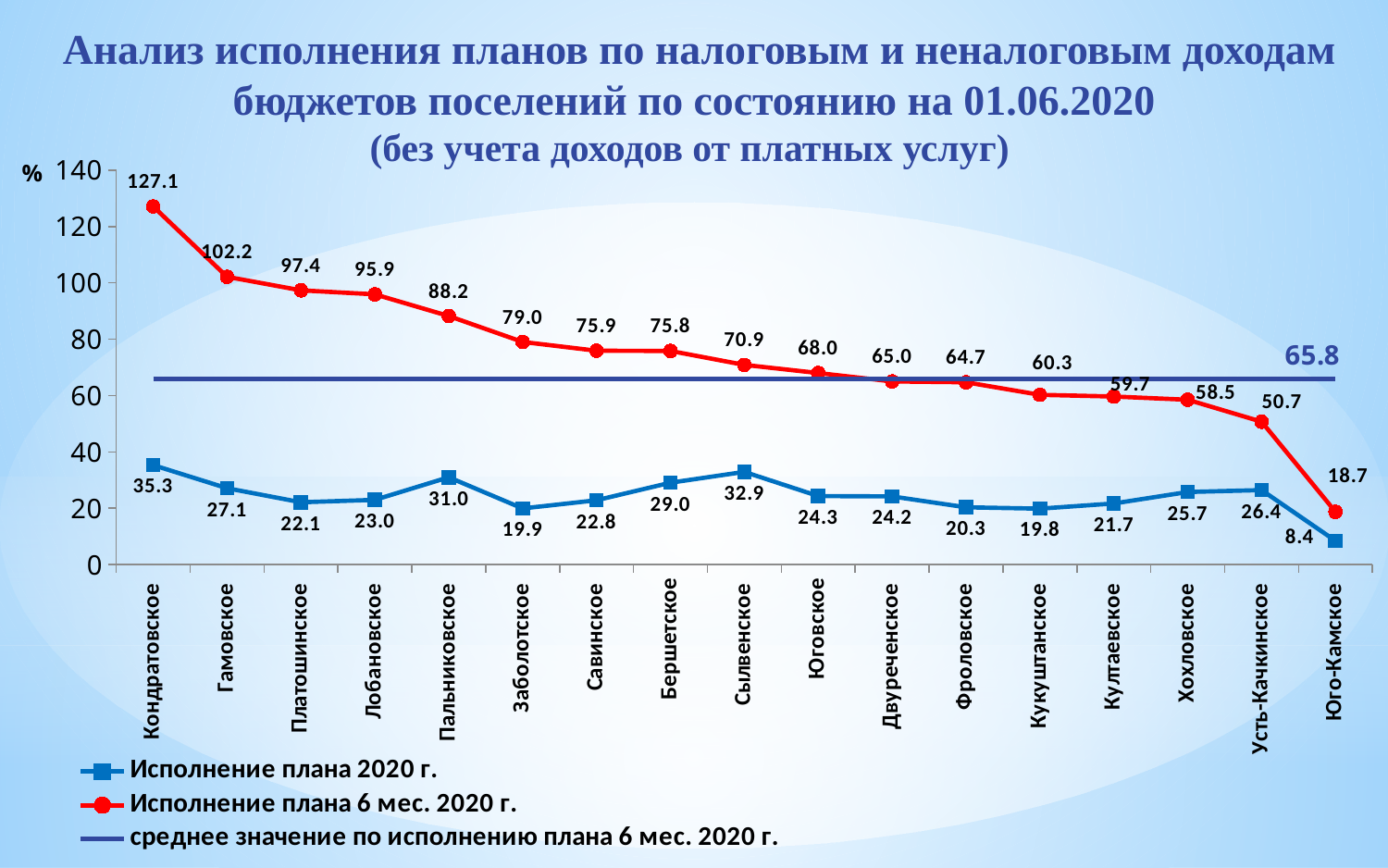
Which settlement has the lowest value for "Исполнение плана 2020 г."? Юго-Камское Which settlement has the highest value for "Исполнение плана 6 мес. 2020 г."? Кондратовское Does the "Исполнение плана 6 мес. 2020 г." series rise or fall from left to right along the x axis? Fall What is the value of "Исполнение плана 6 мес. 2020 г." for Юго-Камское? 18.7 What kind of chart is shown on the slide? Line chart What is the value of the average line "среднее значение по исполнению плана 6 мес. 2020 г."? 65.8 Which has the larger value for "Исполнение плана 2020 г.": Заболотское or Савинское? Савинское How many series does the legend list? 3 For Кондратовское, what is the difference between "Исполнение плана 6 мес. 2020 г." and "Исполнение плана 2020 г."? 91.8 What is the value of "Исполнение плана 6 мес. 2020 г." for Пальниковское? 88.2 What is the value of "Исполнение плана 2020 г." for Сылвенское? 32.9 How many settlements are shown on the x axis? 17